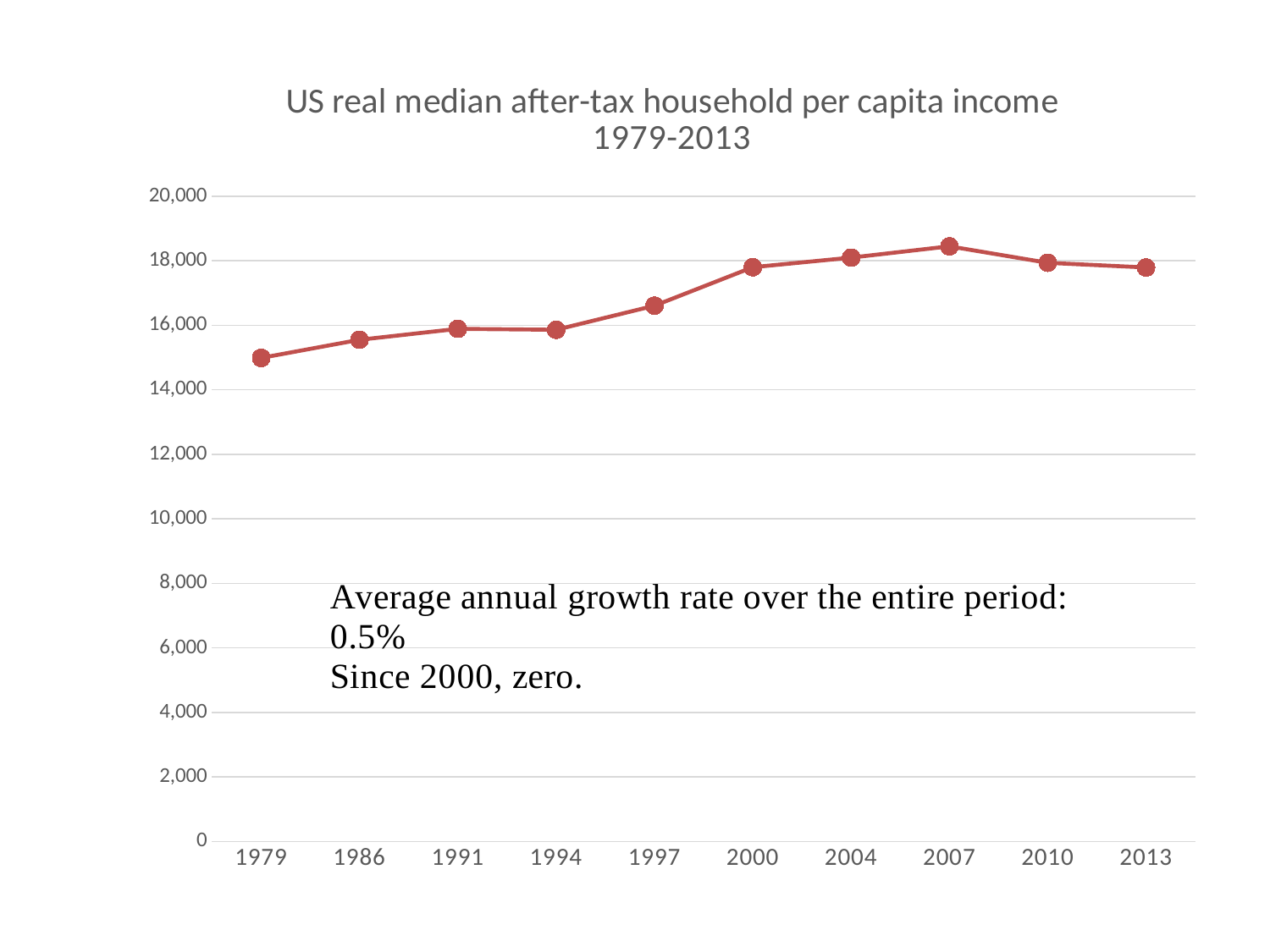
Is the value for 1979 greater or less than 16,000? less Is the value for 1986 greater or less than 16,000? less According to the text on the slide, what is the average annual growth rate over the entire period? 0.5% Which is larger, the value for 1997 or the value for 1991? 1997 Which year has the lowest value? 1979 Does the value rise or fall from 1979 to 2007? rise How many data points are plotted on the line? 10 Is the value for 1997 greater or less than 16,000? greater What is the title of the chart? US real median after-tax household per capita income 1979-2013 Which year has the highest value? 2007 What kind of chart is shown on the slide? line chart